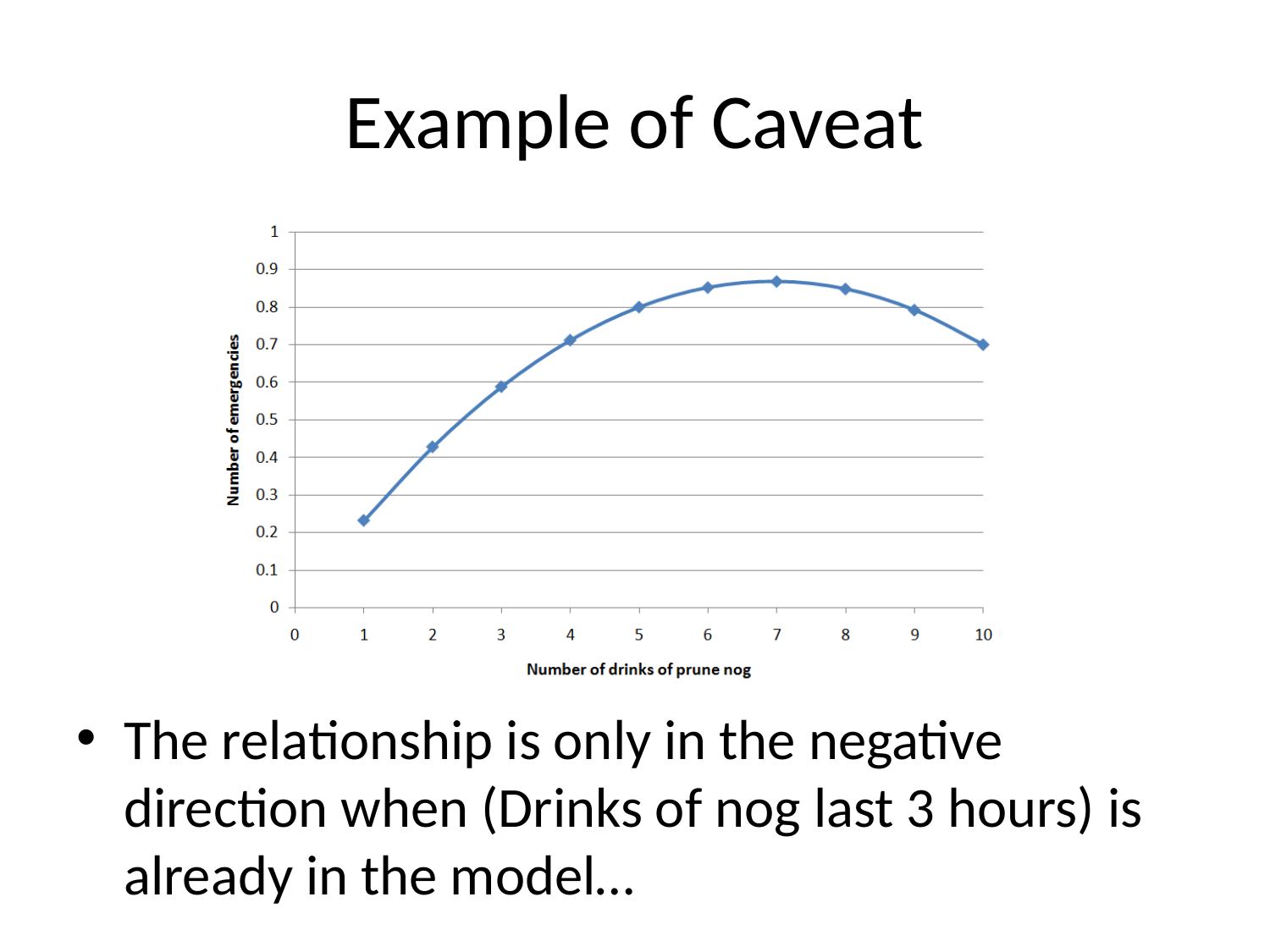
Is the number of emergencies at 3 drinks of prune nog greater or less than 0.5? greater At which number of drinks of prune nog is the number of emergencies lowest? 1 At which number of drinks of prune nog is the number of emergencies highest? 7 Is the number of emergencies at 7 drinks of prune nog greater or less than 0.9? less Is the number of emergencies at 1 drink of prune nog greater or less than 0.3? less Does the number of emergencies rise or fall as the number of drinks increases from 7 to 10? fall Does the number of emergencies rise or fall as the number of drinks increases from 1 to 7? rise How many data points are plotted on the chart? 10 What kind of chart is shown on the slide? line chart What is the label of the x axis of the chart? Number of drinks of prune nog Which has a higher number of emergencies: 2 drinks of prune nog or 9 drinks of prune nog? 9 drinks